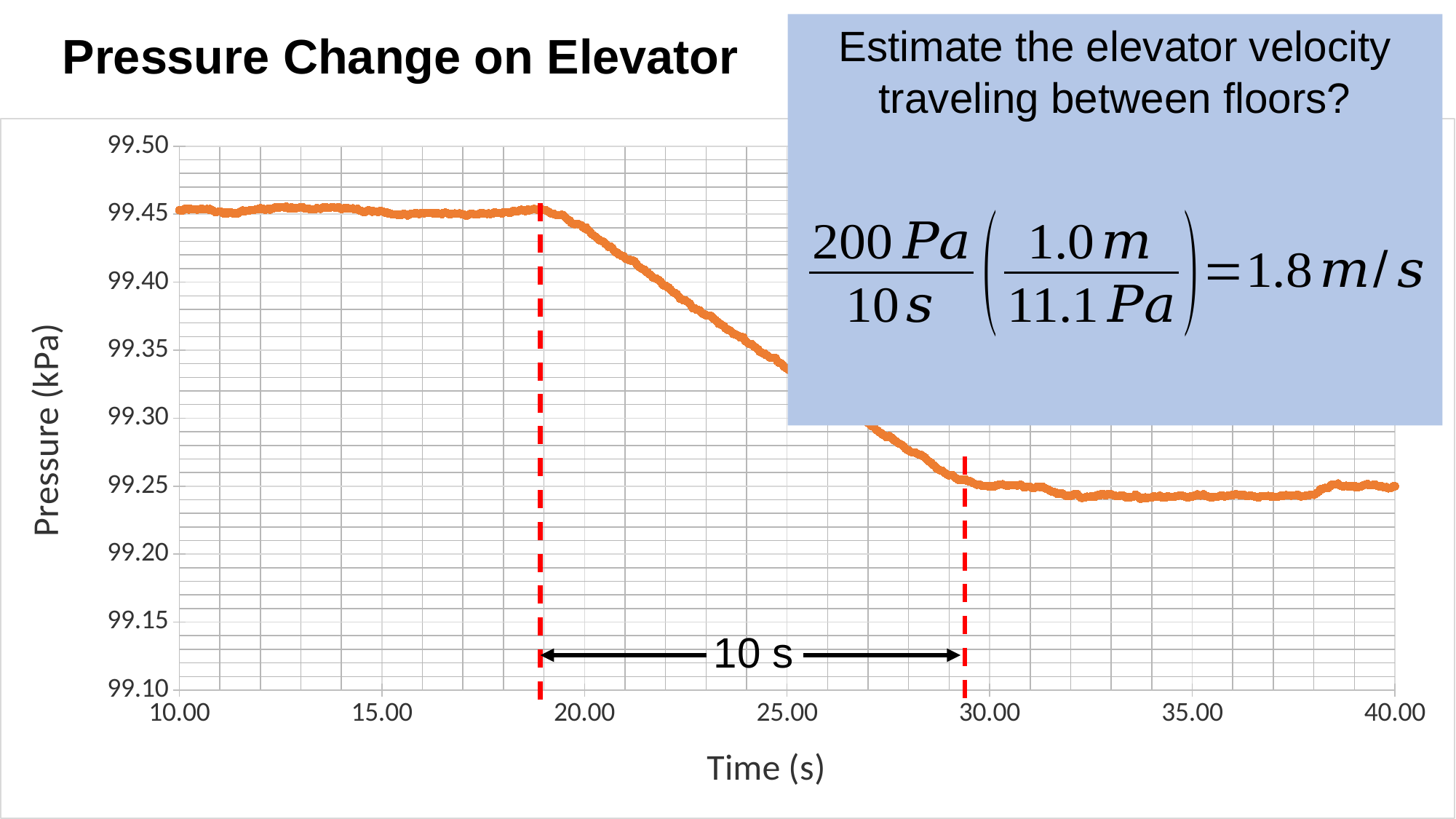
What is the label of the vertical axis? Pressure (kPa) Is the pressure at 15.00 s greater or less than 99.40? greater What is the title of the chart? Pressure Change on Elevator Is the pressure at 40.00 s greater or less than 99.20? greater What time interval is marked by the arrow between the two dashed red lines? 10 s Does the pressure rise or fall between 20.00 s and 30.00 s? fall Is the pressure at 25.00 s greater or less than 99.40? less Overall, does the pressure rise or fall from 10.00 s to 40.00 s? fall What kind of chart is shown on the slide? line chart What is the highest tick value shown on the vertical axis? 99.50 Which is higher, the pressure at 15.00 s or the pressure at 35.00 s? 15.00 s